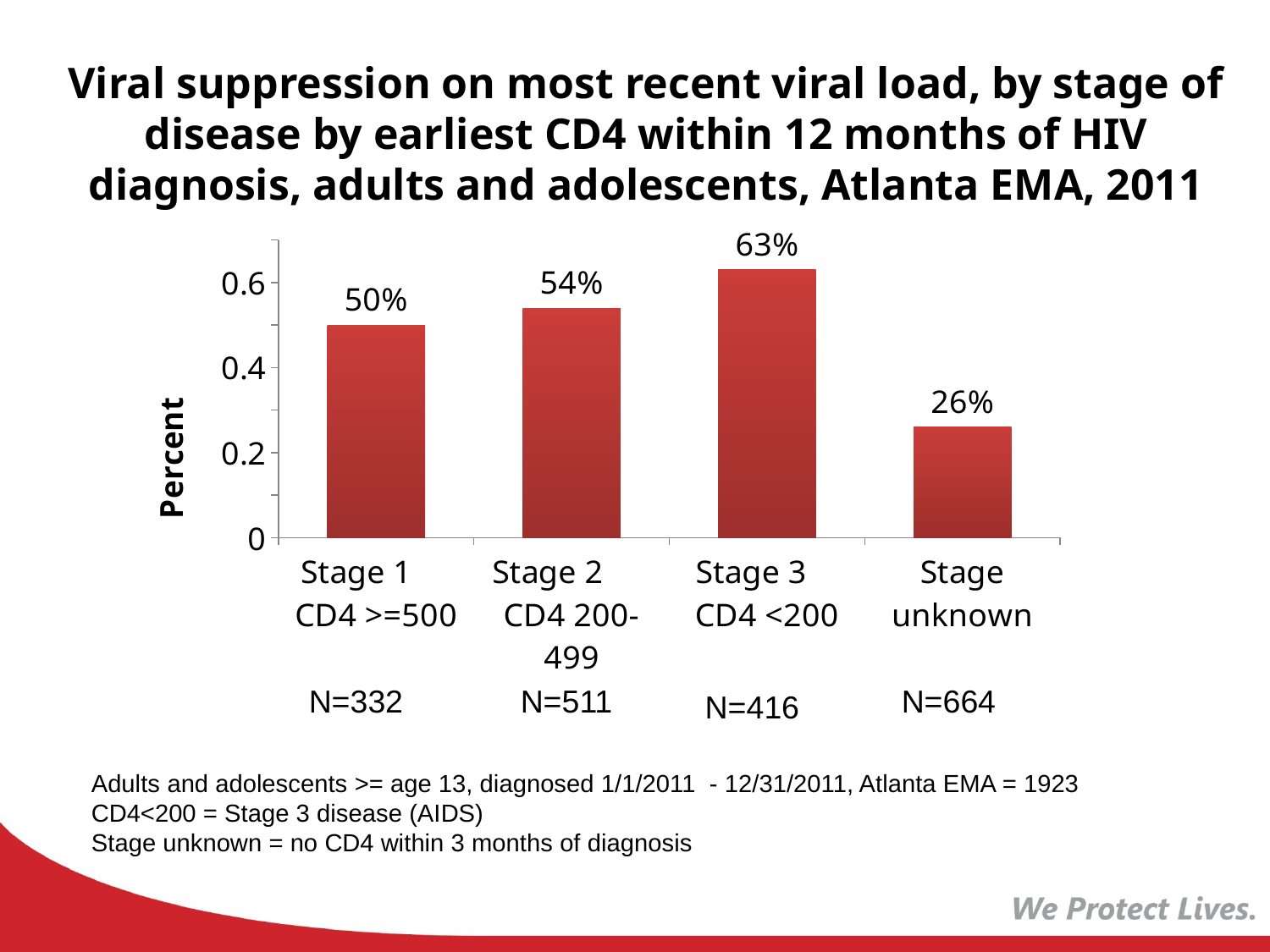
What is the viral suppression value for Stage unknown? 26% How many stage categories are shown on the chart? 4 What is the difference in viral suppression between Stage 2 CD4 200-499 and Stage 1 CD4 >=500? 4% Which has a higher viral suppression percentage, Stage 1 CD4 >=500 or Stage 3 CD4 <200? Stage 3 CD4 <200 What kind of chart is shown on the slide? Bar chart Which stage category has the highest viral suppression percentage? Stage 3 CD4 <200 Which stage category has the lowest viral suppression percentage? Stage unknown What is the label of the vertical axis of the chart? Percent What is the viral suppression value for Stage 1 CD4 >=500? 50% What is the viral suppression value for Stage 3 CD4 <200? 63% What is the difference in viral suppression between Stage 3 CD4 <200 and Stage unknown? 37% What is the viral suppression value for Stage 2 CD4 200-499? 54%